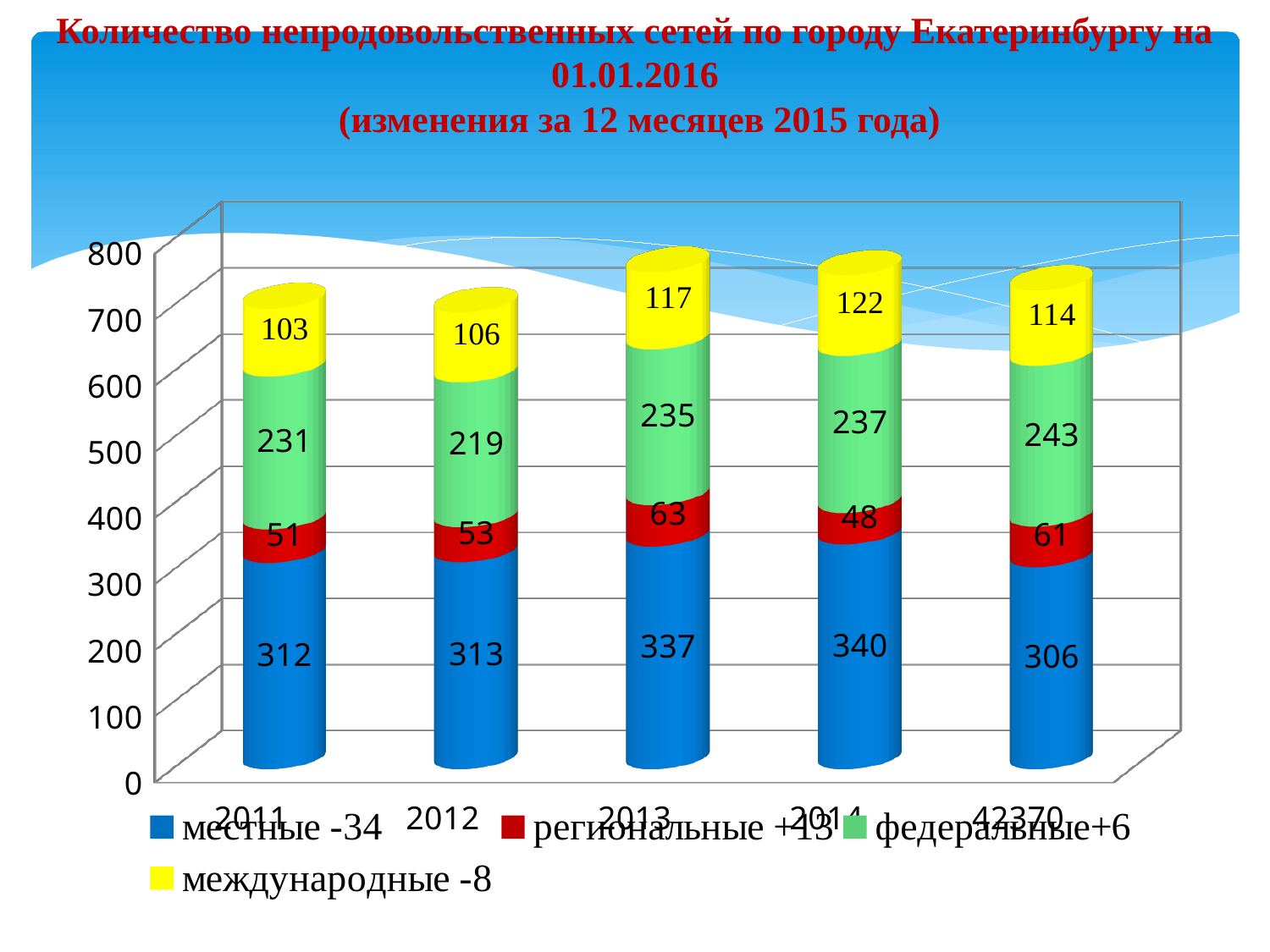
What is the value of the международные segment for 2014? 122 What type of chart is shown on the slide? bar chart What is the value of the местные segment for 2013? 337 In which year is the региональные segment the smallest? 2014 How many bars (categories) are plotted on the chart? 5 What is the total of the stacked bar for 2013? 752 What is the value of the федеральные segment in the rightmost bar (labelled 42370)? 243 In which year is the местные segment the largest? 2014 Which is larger, the международные value for 2013 or for 2012? 2013 Which colour represents the международные series in the legend? yellow How many series does the legend list? 4 What is the difference between the федеральные values for 2011 and 2012? 12